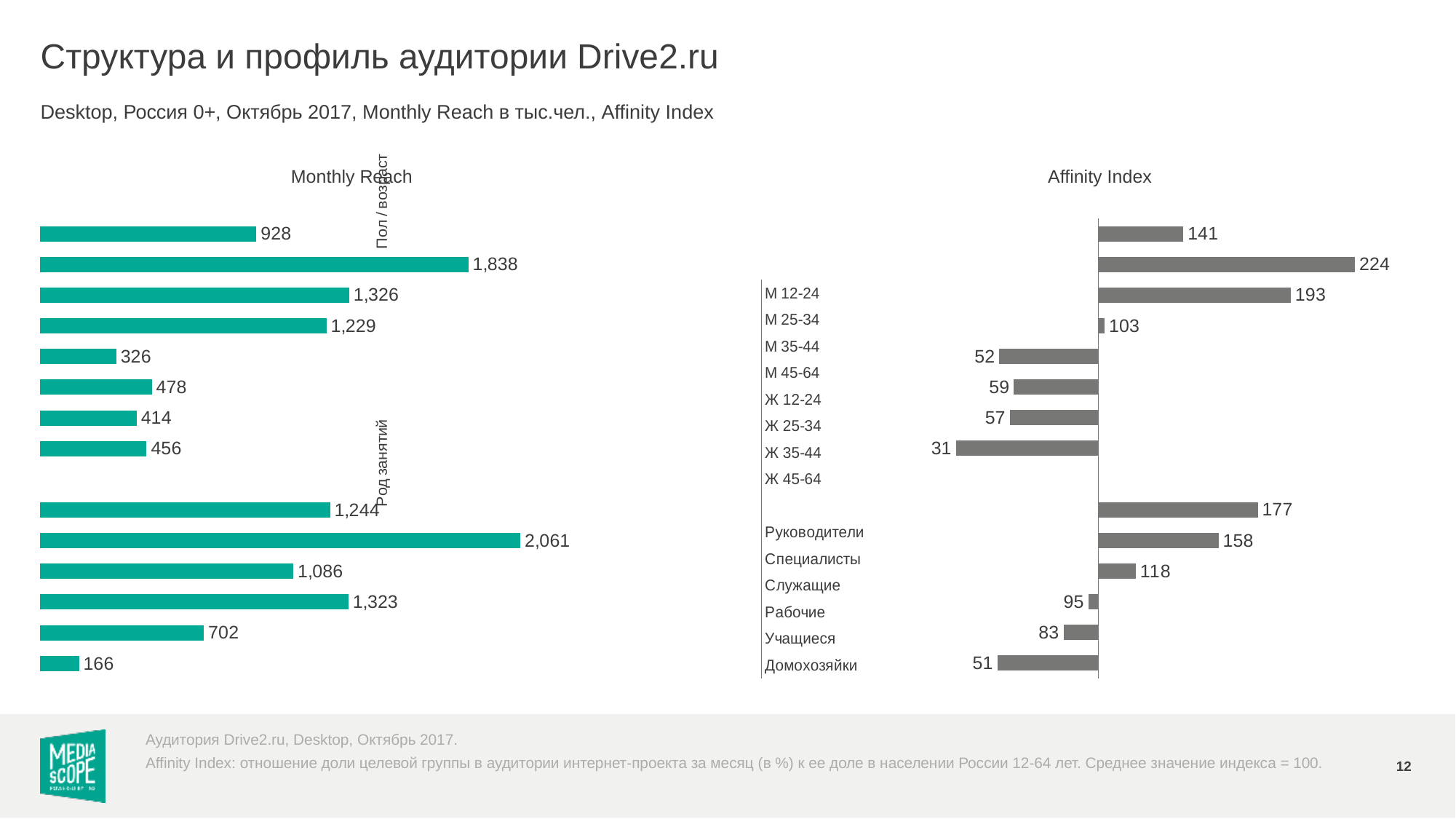
In the Affinity Index chart, what is the highest value shown? 224 In the Affinity Index chart, what is the lowest value shown? 31 In the Monthly Reach chart, what is the value of the topmost bar? 928 What month and year does the slide subtitle say the data refers to? Октябрь 2017 In the Affinity Index chart, how many bars have a value above 100? 7 In the Monthly Reach chart, what is the highest value shown? 2,061 In the Monthly Reach chart, what is the difference between the highest value (2,061) and the lowest value (166)? 1,895 What kind of chart is the Monthly Reach chart on the left? Bar chart How many bars are plotted in the Monthly Reach chart? 14 In the Monthly Reach chart, what is the lowest value shown? 166 In the Monthly Reach chart, which is larger: the topmost bar (928) or the second bar from the top (1,838)? The second bar (1,838) In the Affinity Index chart, what is the value of the topmost bar? 141